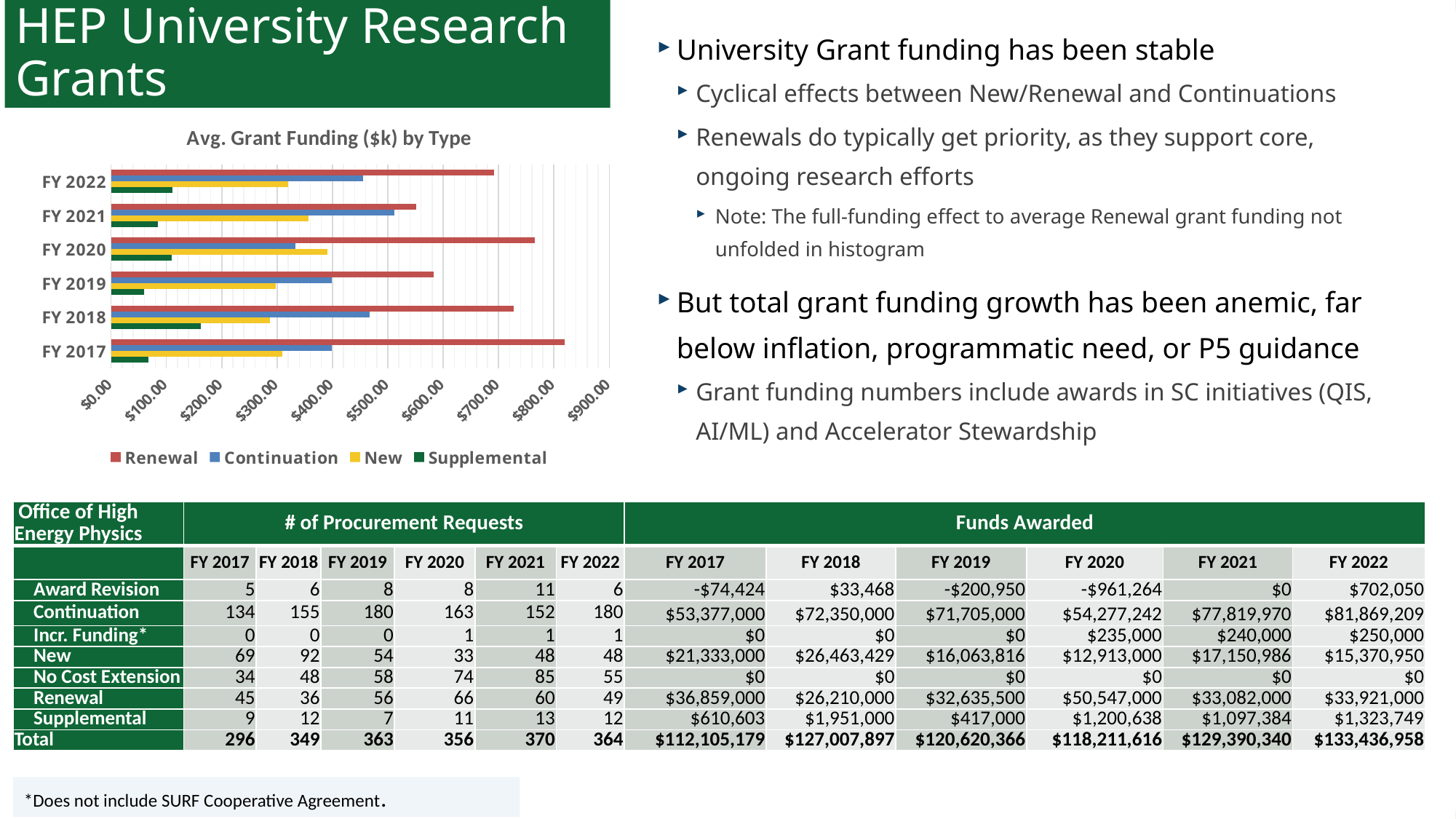
Is the Renewal value for FY 2017 greater or less than $700.00? greater Which colour represents the New series in the chart legend? yellow Is the Supplemental value for FY 2017 greater or less than $100.00? less What kind of chart is shown on the slide? bar chart How many fiscal years are shown on the chart's vertical axis? 6 Is the Continuation value for FY 2022 greater or less than $400.00? greater How many series does the chart legend list? 4 Which series has the shortest bar in every fiscal year on the chart? Supplemental Which series has the longest bar in every fiscal year on the chart? Renewal In which fiscal year is the Renewal bar the longest? FY 2017 What is the title of the chart? Avg. Grant Funding ($k) by Type Which is larger, the Renewal value for FY 2017 or the Renewal value for FY 2022? FY 2017